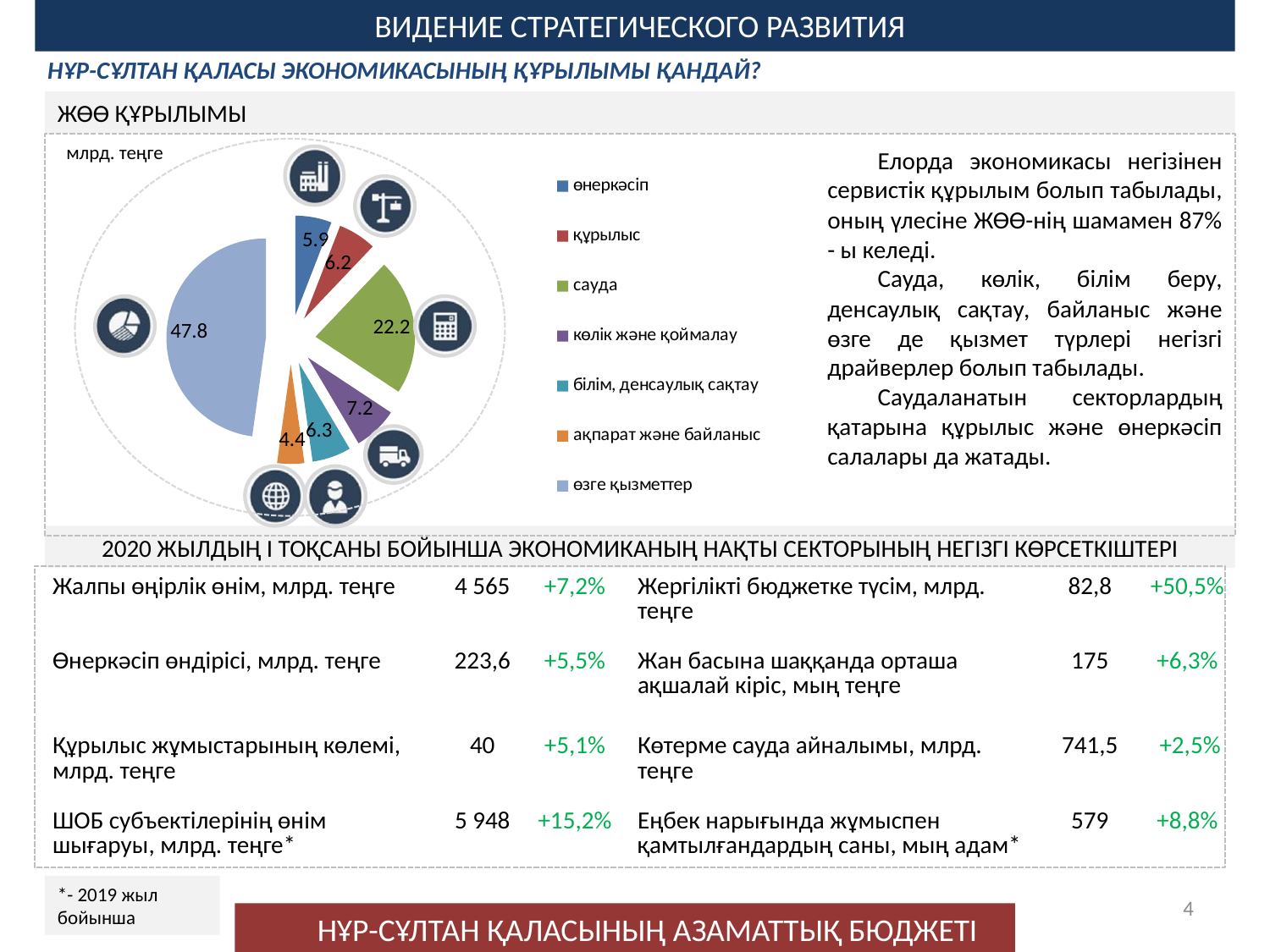
How many categories does the ЖӨӨ ҚҰРЫЛЫМЫ pie chart show? 7 What unit is indicated in the top-left corner of the ЖӨӨ ҚҰРЫЛЫМЫ pie chart? млрд. теңге In the ЖӨӨ ҚҰРЫЛЫМЫ pie chart, what is the difference between the values for өзге қызметтер and сауда? 25.6 What type of chart is used to show the ЖӨӨ ҚҰРЫЛЫМЫ data? pie chart In the ЖӨӨ ҚҰРЫЛЫМЫ pie chart, which is larger: құрылыс or өнеркәсіп? құрылыс Which category has the smallest slice in the ЖӨӨ ҚҰРЫЛЫМЫ pie chart? ақпарат және байланыс In the ЖӨӨ ҚҰРЫЛЫМЫ pie chart, what is the value for ақпарат және байланыс? 4.4 In the ЖӨӨ ҚҰРЫЛЫМЫ pie chart, what is the value for көлік және қоймалау? 7.2 In the ЖӨӨ ҚҰРЫЛЫМЫ pie chart, what is the value for өзге қызметтер? 47.8 In the ЖӨӨ ҚҰРЫЛЫМЫ pie chart, what is the value for сауда? 22.2 In the ЖӨӨ ҚҰРЫЛЫМЫ pie chart, what is the total of all the labelled slice values? 100.0 Which category has the largest slice in the ЖӨӨ ҚҰРЫЛЫМЫ pie chart? өзге қызметтер